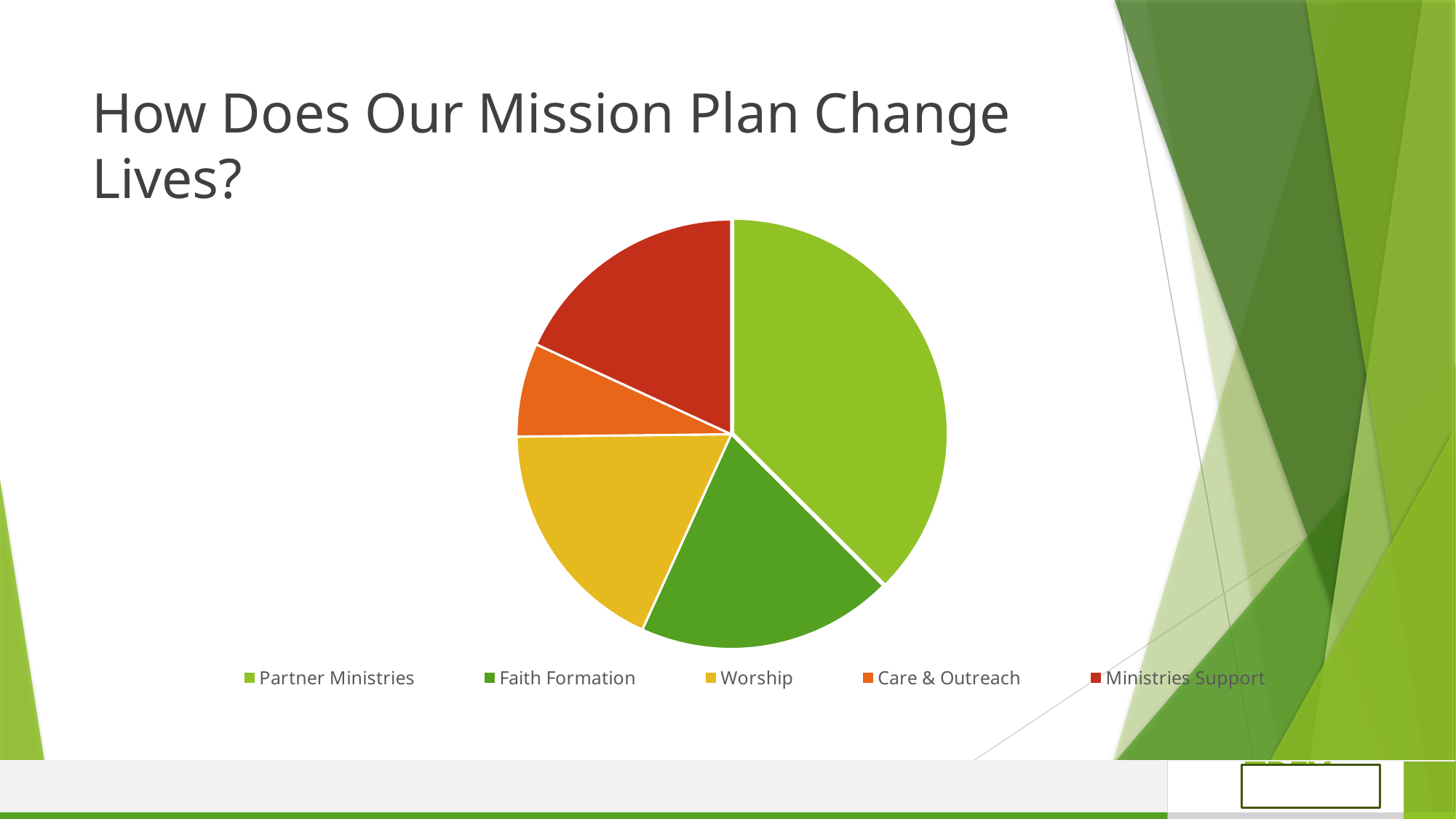
Which category has the largest slice of the pie chart? Partner Ministries Which slice is larger, Partner Ministries or Worship? Partner Ministries Which category has the smallest slice of the pie chart? Care & Outreach What is the title of the slide containing the pie chart? How Does Our Mission Plan Change Lives? How many entries does the legend of the pie chart list? 5 What kind of chart is shown on the slide? pie chart Which slice is larger, Partner Ministries or Ministries Support? Partner Ministries Which category is shown in orange in the pie chart? Care & Outreach Which slice is larger, Faith Formation or Care & Outreach? Faith Formation How many slices does the pie chart have? 5